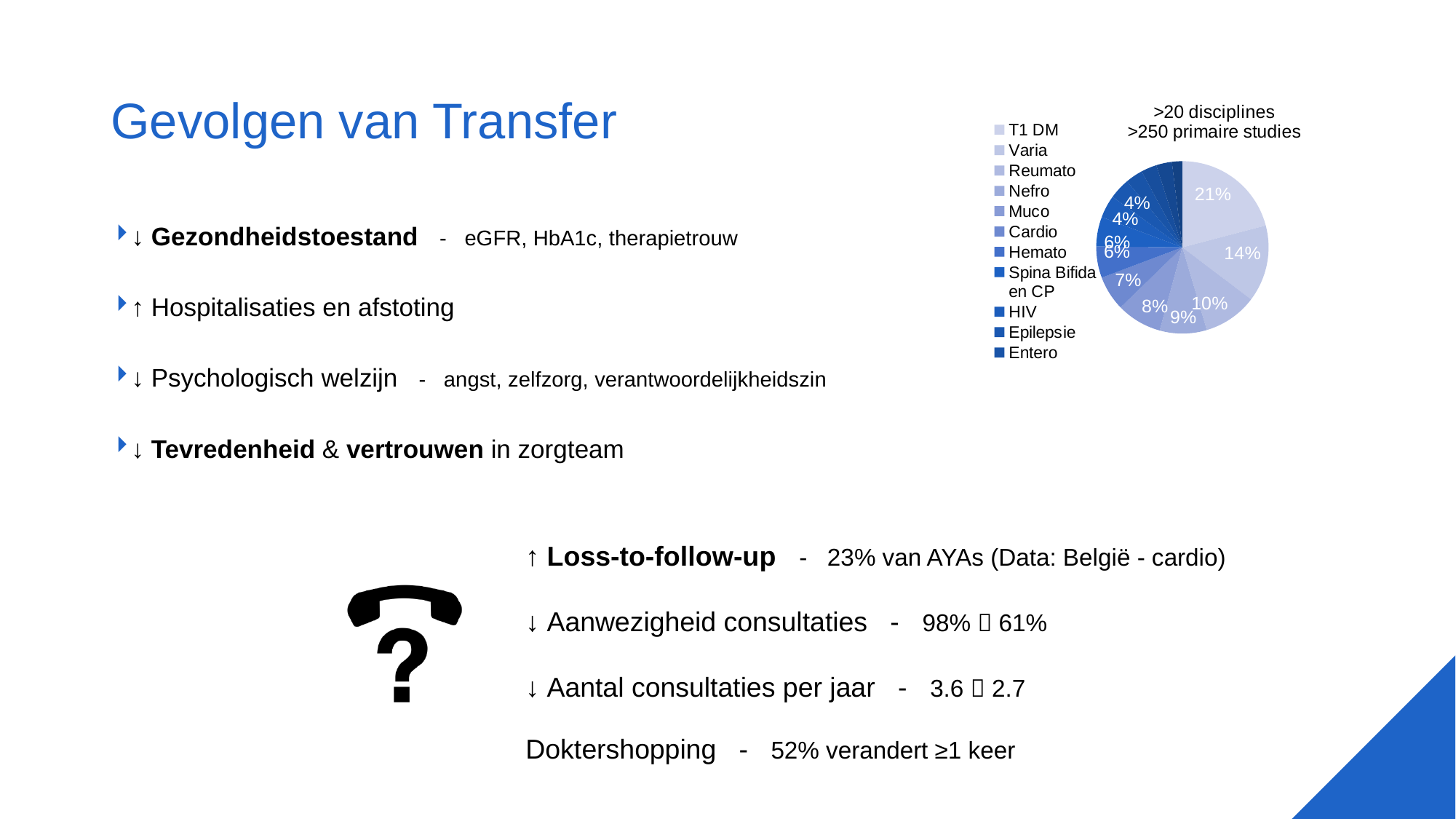
What is the difference between the T1 DM slice and the Varia slice? 7% Which legend entry is listed first in the pie chart legend? T1 DM What is the value shown for Varia in the pie chart? 14% What text appears above the pie chart as its heading? >20 disciplines >250 primaire studies What kind of chart is shown on the slide? pie chart Which category has the largest slice in the pie chart? T1 DM Which slice is larger, Reumato or Nefro? Reumato What is the value shown for Nefro in the pie chart? 9% How many categories does the legend of the pie chart list? 11 What is the value shown for Reumato in the pie chart? 10% Which slice is larger, T1 DM or Varia? T1 DM What percentage of the pie does T1 DM represent? 21%